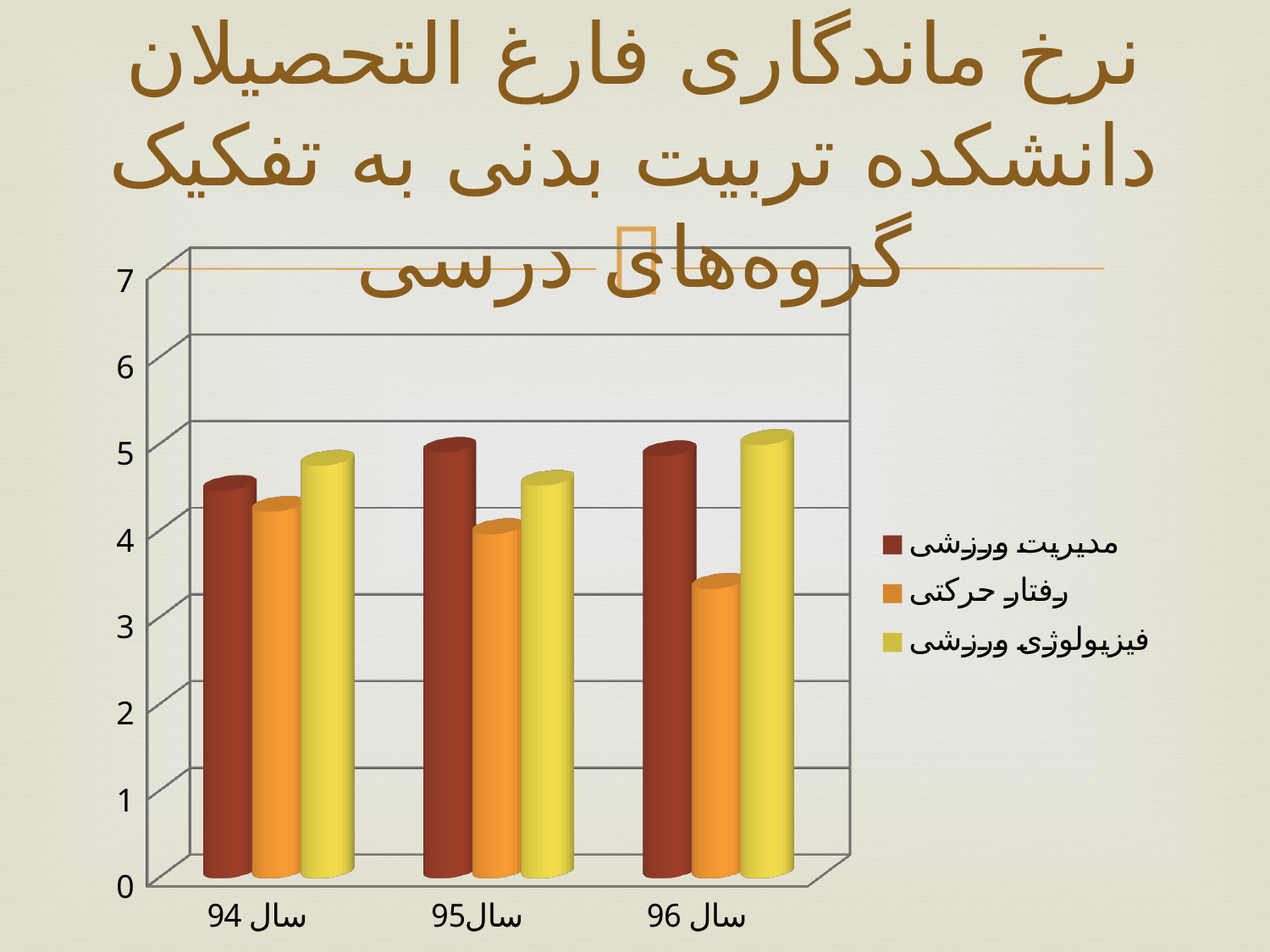
What kind of chart is shown on the slide? bar chart Do the values for رفتار حرکتی rise or fall from سال 94 to سال 96? fall Which series is shown in yellow in the legend? فیزیولوژی ورزشی In سال 96, which is larger: مدیریت ورزشی or رفتار حرکتی? مدیریت ورزشی Which series is shown in dark red in the legend? مدیریت ورزشی Is the value for رفتار حرکتی in سال 96 greater or less than 4? less Which series has the lowest value in سال 96? رفتار حرکتی Which series has the highest value in سال 94? فیزیولوژی ورزشی Is the value for فیزیولوژی ورزشی in سال 96 greater or less than 4? greater How many year categories are shown on the x axis? 3 Is the value for مدیریت ورزشی in سال 94 greater or less than 4? greater How many series does the legend list? 3